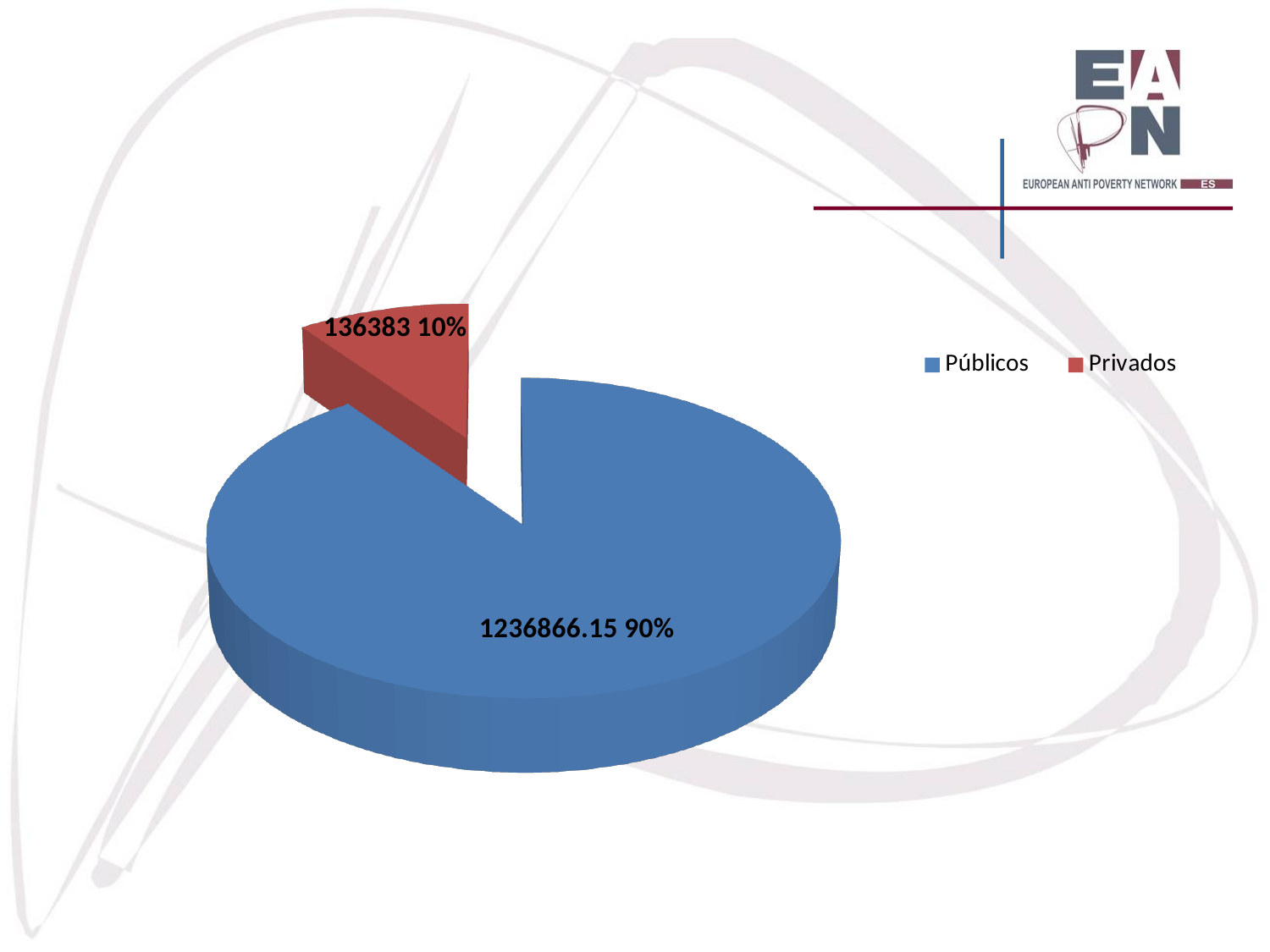
What colour is the Públicos slice? blue What percentage share of the pie does Privados represent? 10% What kind of chart is shown on the slide? pie chart Which is larger, Públicos or Privados? Públicos What colour is the Privados slice? red What percentage share of the pie does Públicos represent? 90% What is the value shown for Públicos? 1236866.15 What is the value shown for Privados? 136383 Which category has the largest slice of the pie? Públicos How many categories does the pie chart show? 2 Which category has the smallest slice of the pie? Privados How many entries does the legend list? 2